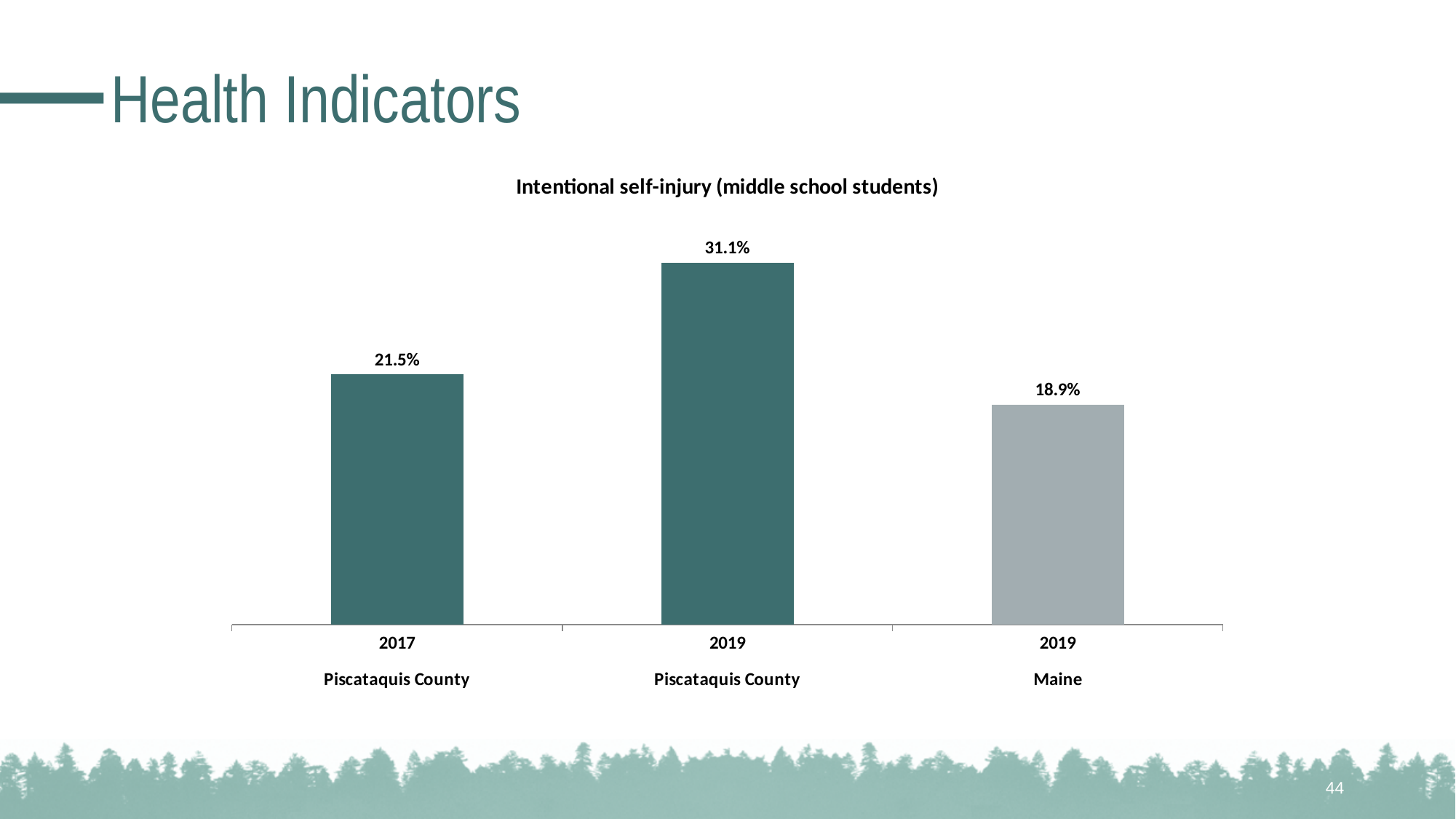
What is the value for Maine in 2019? 18.9% Which bar has the lowest value? 2019 Maine Which bar has the highest value? 2019 Piscataquis County Which is larger, the 2019 value for Piscataquis County or the 2019 value for Maine? Piscataquis County What is the value for Piscataquis County in 2019? 31.1% Did the Piscataquis County value rise or fall from 2017 to 2019? Rise What is the difference between the Piscataquis County values for 2019 and 2017? 9.6% How many bars are shown in the chart? 3 What is the title of the chart? Intentional self-injury (middle school students) What is the difference between Piscataquis County and Maine in 2019? 12.2% What is the value for Piscataquis County in 2017? 21.5% What kind of chart is shown on the slide? Bar chart